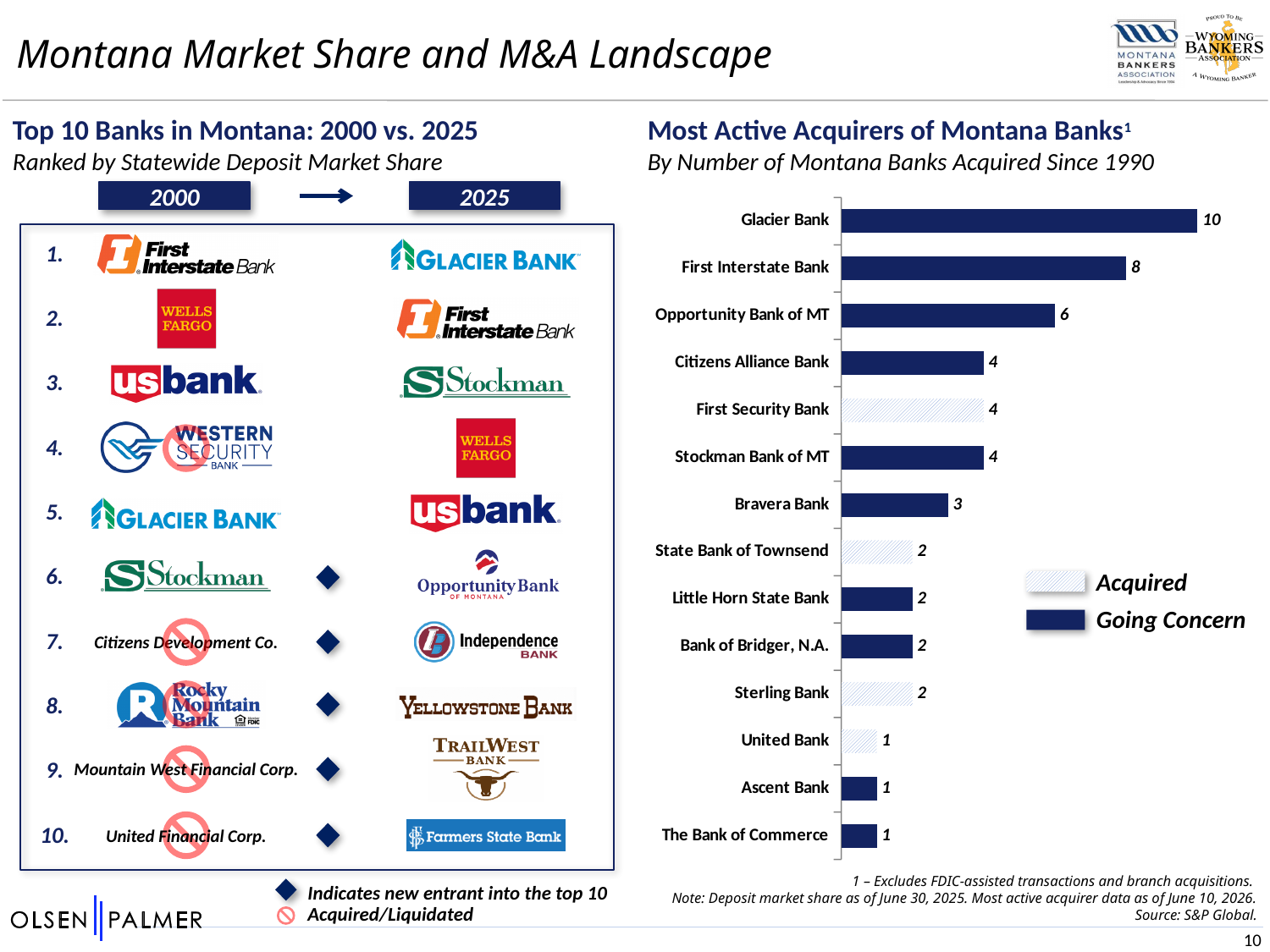
How many banks are listed in the 'Most Active Acquirers of Montana Banks' chart? 14 In the 'Most Active Acquirers of Montana Banks' chart, what are the two legend entries? Acquired and Going Concern In the 'Most Active Acquirers of Montana Banks' chart, what is the difference between First Interstate Bank and Stockman Bank of MT? 4 In the 'Most Active Acquirers of Montana Banks' chart, what is the value for Opportunity Bank of MT? 6 What kind of chart is the 'Most Active Acquirers of Montana Banks' chart? Bar chart In the 'Most Active Acquirers of Montana Banks' chart, which is larger: the value for Bravera Bank or the value for Sterling Bank? Bravera Bank In the 'Most Active Acquirers of Montana Banks' chart, which bank has the highest number of Montana banks acquired? Glacier Bank In the 'Most Active Acquirers of Montana Banks' chart, what is the value for Bravera Bank? 3 In the 'Most Active Acquirers of Montana Banks' chart, how many Montana banks has Glacier Bank acquired since 1990? 10 In the 'Most Active Acquirers of Montana Banks' chart, which is larger: the value for Opportunity Bank of MT or the value for Citizens Alliance Bank? Opportunity Bank of MT How many entries does the legend of the 'Most Active Acquirers of Montana Banks' chart list? 2 In the 'Most Active Acquirers of Montana Banks' chart, what is the difference between Glacier Bank and First Interstate Bank? 2